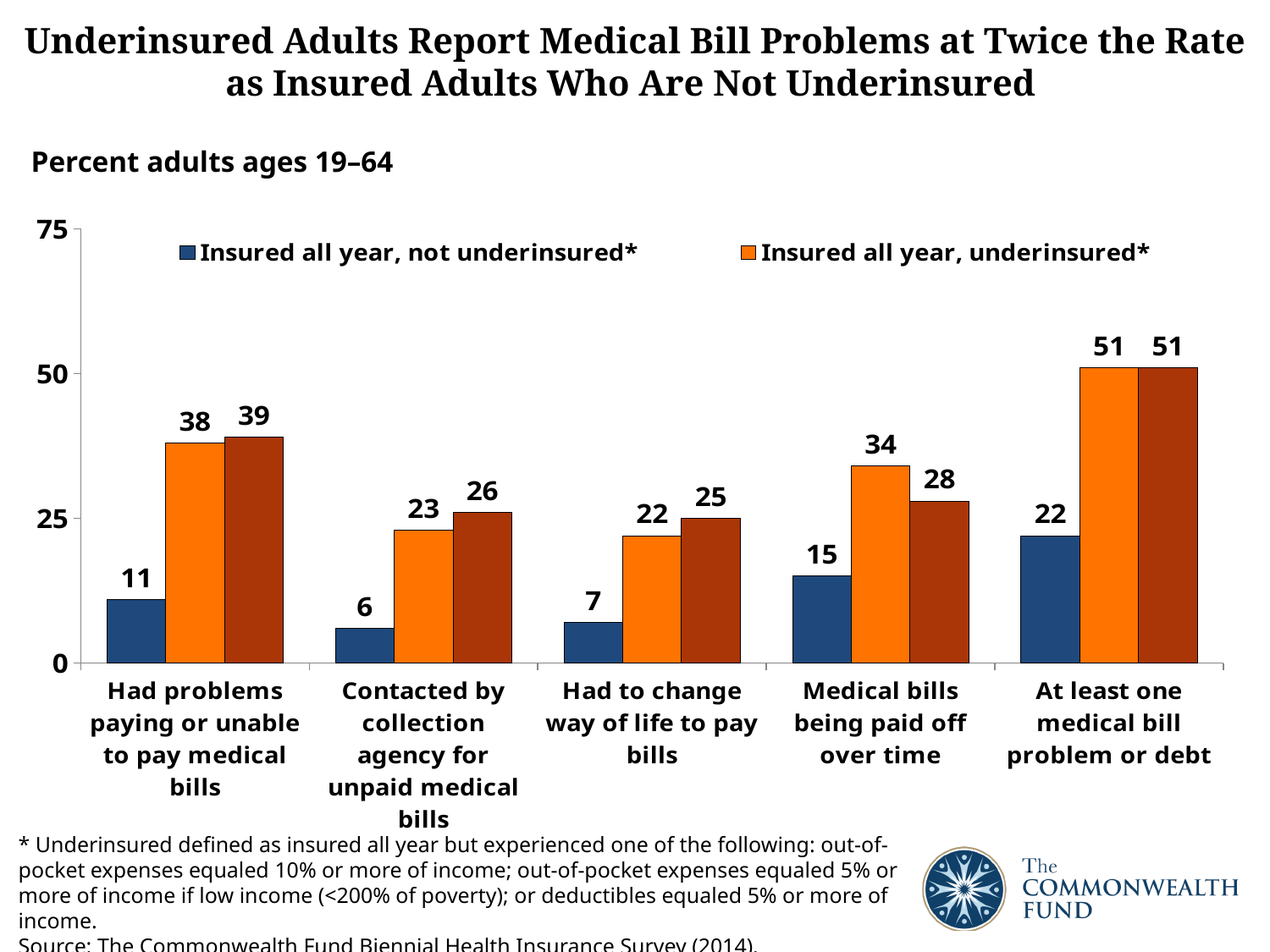
How many series does the chart's legend list? 2 Which is larger in the "Medical bills being paid off over time" category: the value for "Insured all year, not underinsured*" or for "Insured all year, underinsured*"? Insured all year, underinsured* What is the value for "Insured all year, underinsured*" in the "Contacted by collection agency for unpaid medical bills" category? 23 What is the value for "Insured all year, not underinsured*" in the "Had problems paying or unable to pay medical bills" category? 11 What kind of chart is shown on the slide? bar chart Is the value for "Insured all year, underinsured*" in the "Had problems paying or unable to pay medical bills" category greater or less than 25? greater Which category has the lowest value for "Insured all year, not underinsured*"? Contacted by collection agency for unpaid medical bills Which category has the highest value for "Insured all year, underinsured*"? At least one medical bill problem or debt How many categories are shown on the x axis of the chart? 5 What is the value for "Insured all year, underinsured*" in the "Medical bills being paid off over time" category? 34 What is the difference between the "Insured all year, underinsured*" and "Insured all year, not underinsured*" values in the "At least one medical bill problem or debt" category? 29 What is the value for "Insured all year, not underinsured*" in the "Had to change way of life to pay bills" category? 7